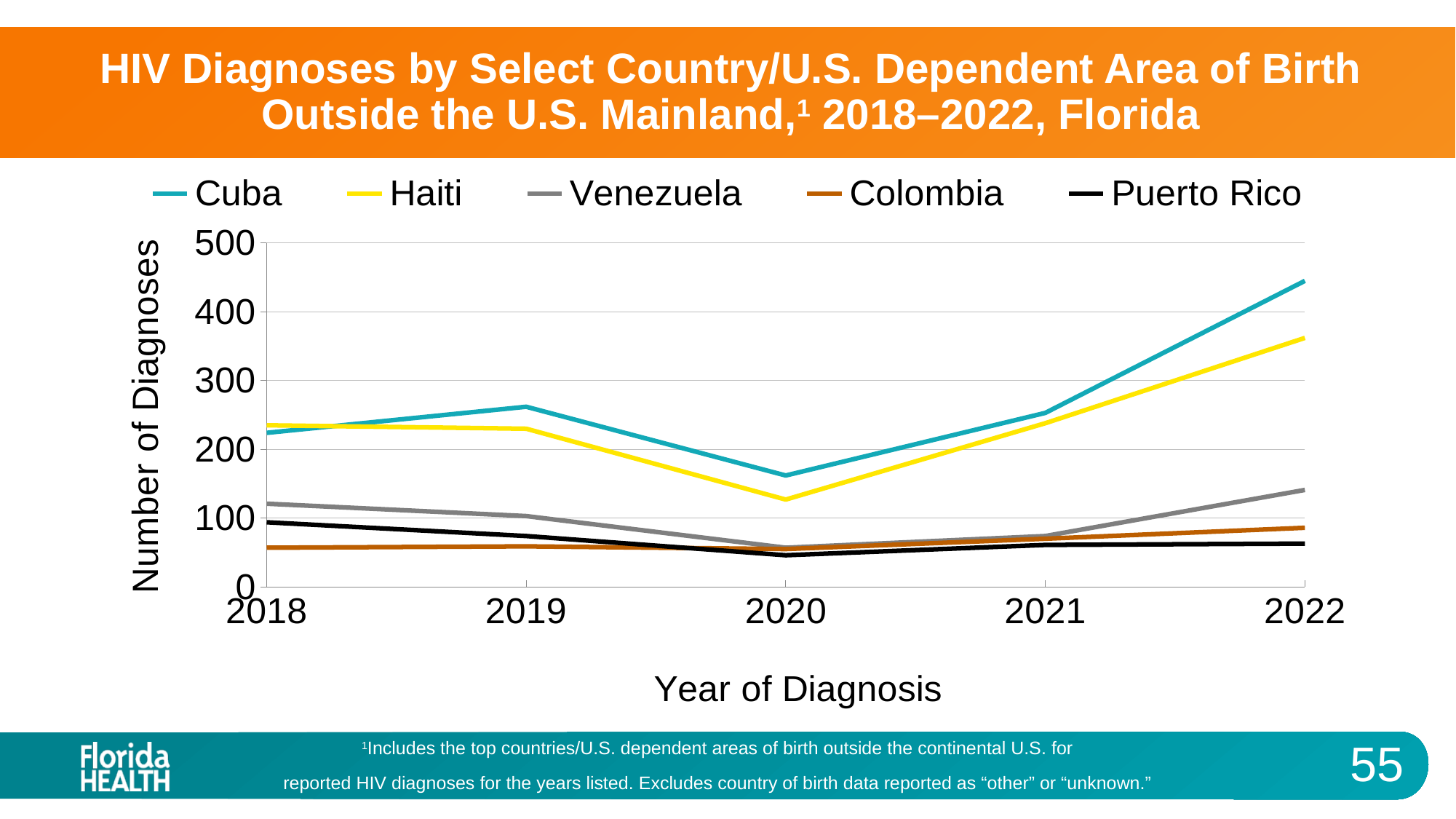
Which is larger in 2022, the value for Cuba or the value for Haiti? Cuba Which is larger in 2018, the value for Venezuela or the value for Puerto Rico? Venezuela Is the value for Venezuela in 2018 greater or less than 100? greater How many years are shown along the x axis? 5 Is the value for Cuba in 2022 greater or less than 400? greater Is the value for Haiti in 2020 greater or less than 200? less In which year is the value for Cuba lowest? 2020 Do the values for Cuba rise or fall from 2020 to 2022? rise Which country/area has the highest number of diagnoses in 2022? Cuba What kind of chart is shown on the slide? line chart Which country/area has the lowest number of diagnoses in 2022? Puerto Rico How many series does the legend list? 5